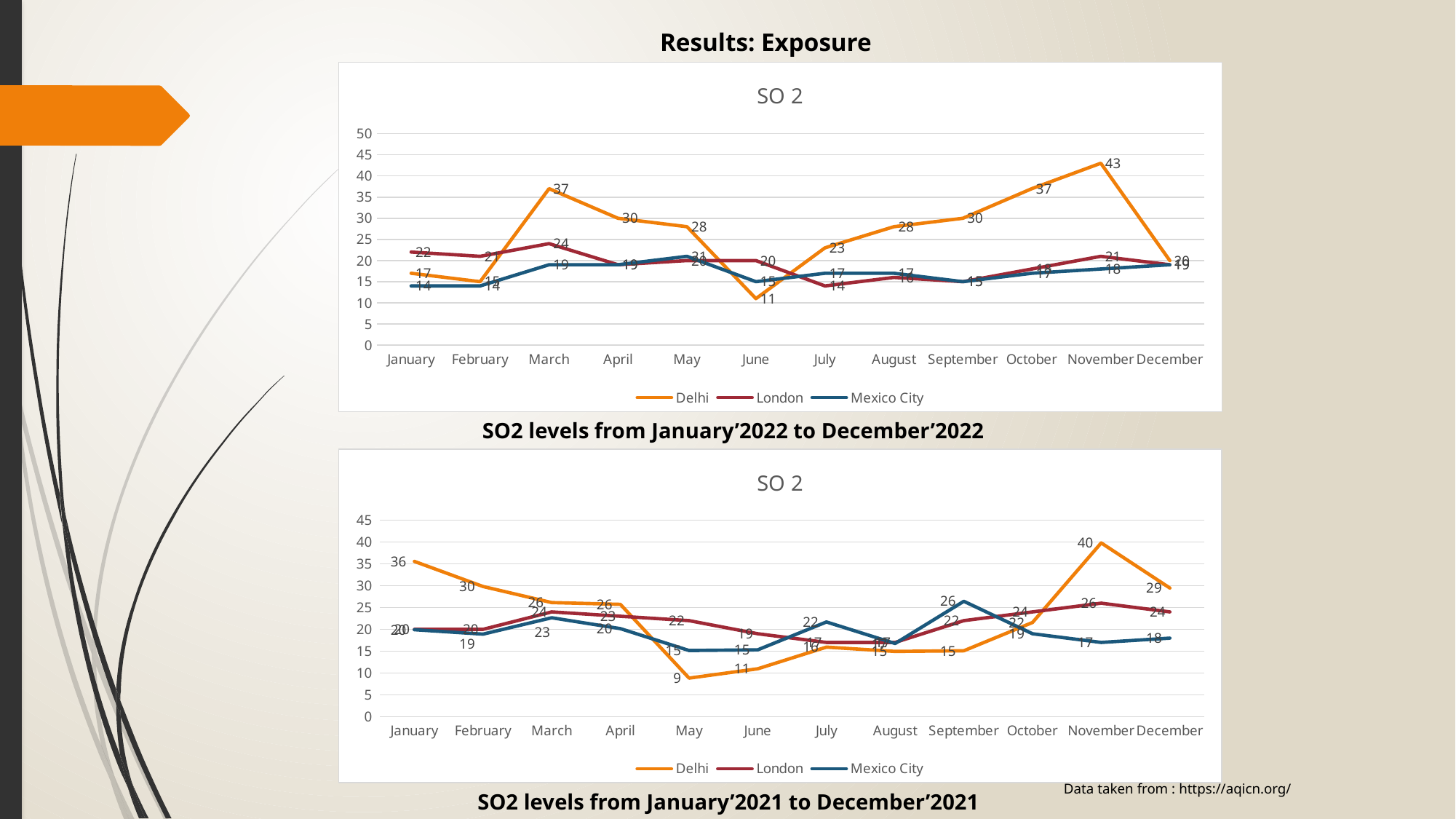
How many series does the legend of the top chart list? 3 In the top chart (SO2 levels 2022), what is the difference between the Delhi value in March (37) and the Delhi value in February (15)? 22 In the top chart (SO2 levels 2022), what is the value for Delhi in November? 43 In the bottom chart (SO2 levels 2021), which month has the highest Delhi value? November What kind of chart is the bottom chart (SO2 levels 2021)? Line chart In the bottom chart (SO2 levels 2021), what is the value for Delhi in May? 9 In the top chart (SO2 levels 2022), what is the value for Delhi in June? 11 In the top chart (SO2 levels 2022), which month has the highest Delhi value? November In the bottom chart (SO2 levels 2021), which is larger in January: the Delhi value or the London value? Delhi In the top chart (SO2 levels 2022), is the Delhi value in October greater or less than 30? greater In the bottom chart (SO2 levels 2021), what is the value for Mexico City in September? 26 How many months are shown on the x axis of the bottom chart? 12